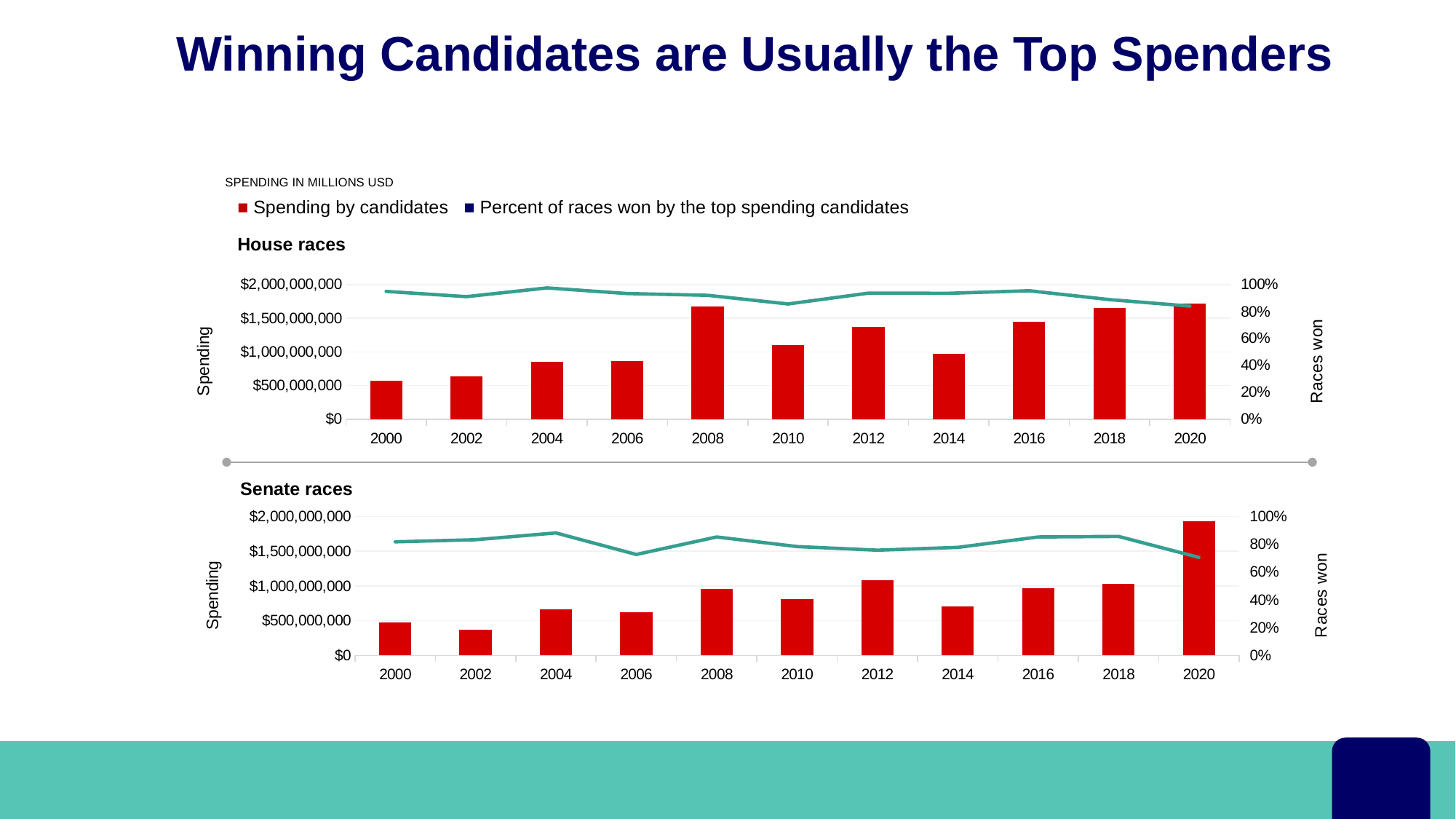
In the House races chart, which year has higher spending by candidates, 2008 or 2010? 2008 What kind of chart is the House races chart? Bar chart with a line In the Senate races chart, which year has the highest spending by candidates? 2020 In the Senate races chart, which year has the lowest spending by candidates? 2002 In the Senate races chart, which year has higher spending by candidates, 2014 or 2016? 2016 How many years are shown on the x axis of the Senate races chart? 11 How many series does the legend list? 2 In the Senate races chart, is spending by candidates in 2020 greater or less than $1,500,000,000? greater In the House races chart, is spending by candidates in 2008 greater or less than $1,500,000,000? greater What is the label of the right-hand vertical axis on the House races chart? Races won In the House races chart, is spending by candidates in 2000 greater or less than $1,000,000,000? less In the House races chart, which year has the lowest spending by candidates? 2000